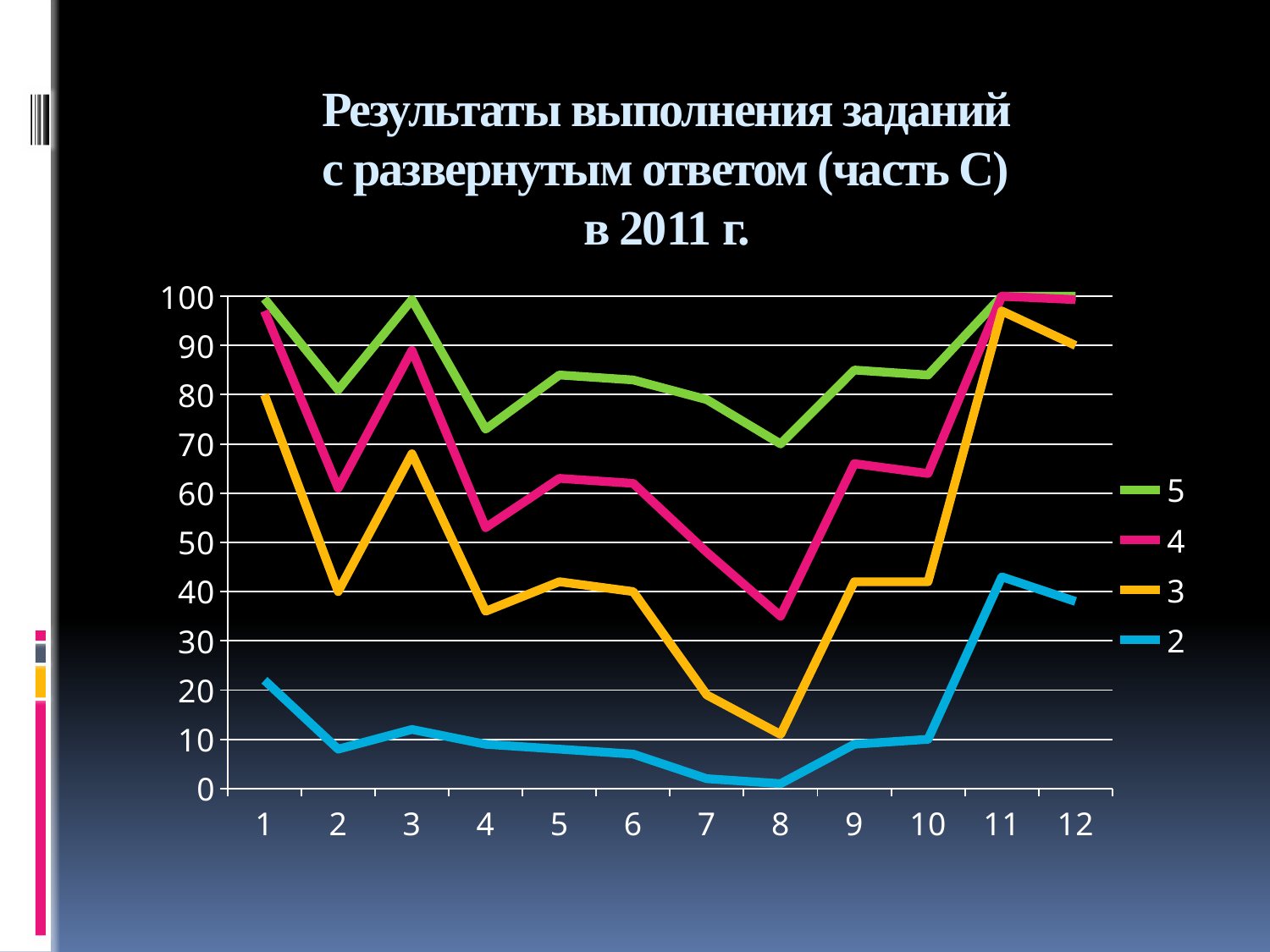
Is the value of series 4 at category 8 greater or less than 40? less At category 3, which is larger: the value of series 4 or the value of series 3? series 4 Is the value of series 2 at category 11 greater or less than 40? greater Which series has the highest value at category 8? 5 Which series has the lowest value at category 8? 2 How many categories are shown on the x axis? 12 How many series does the legend list? 4 What kind of chart is shown on the slide? line chart Does series 3 rise or fall from category 10 to category 11? rise Is the value of series 2 at category 8 greater or less than 10? less Which colour is used for series 2 in the chart? blue